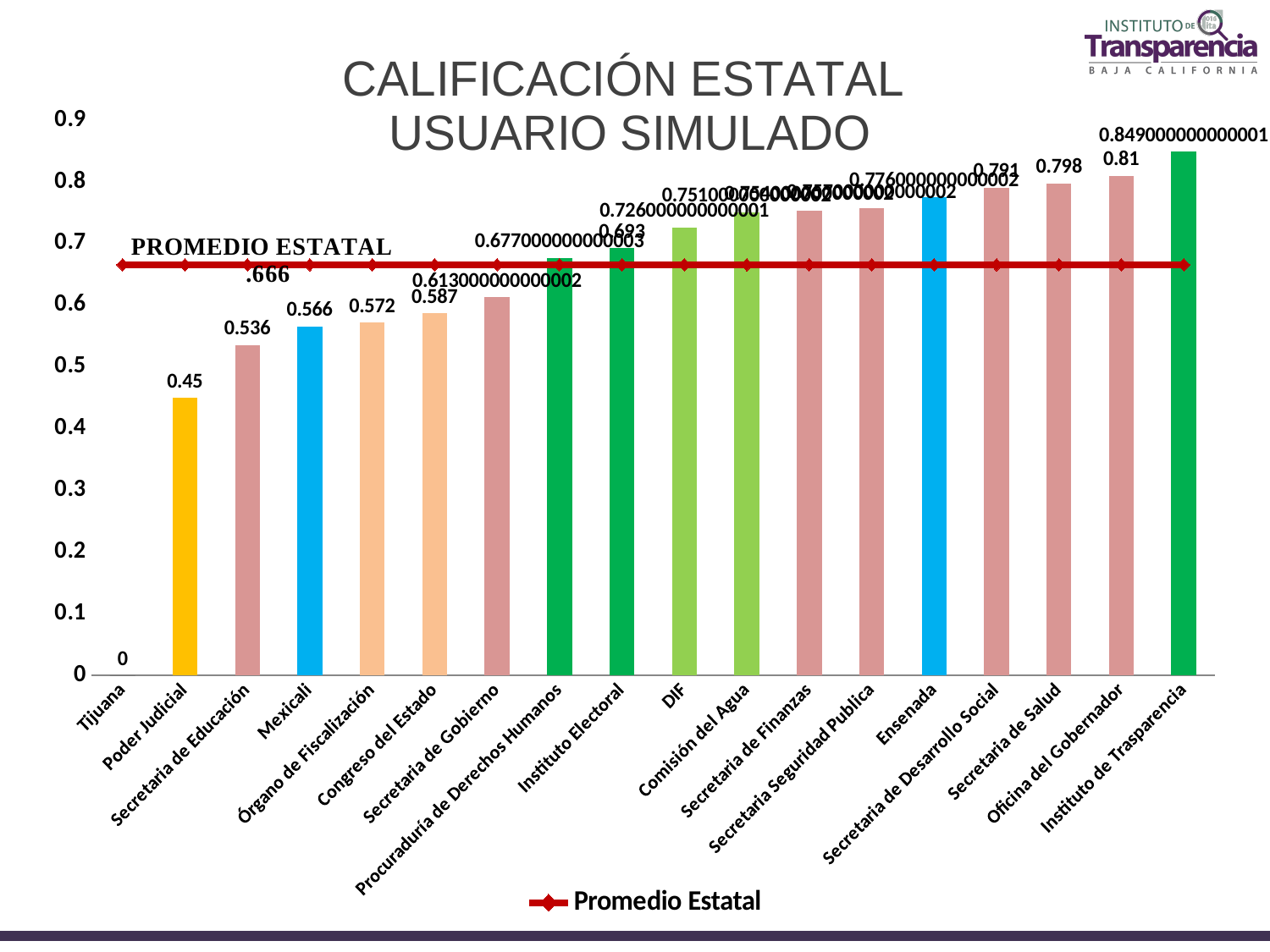
How many series does the legend list? 1 Which category has the highest value? Instituto de Trasparencia Which is larger, the value for Secretaria de Educación or the value for Congreso del Estado? Congreso del Estado What is the value for Instituto Electoral? 0.693 Which category has the lowest value? Tijuana What value is shown for the Promedio Estatal line? .666 What is the value for Secretaria de Salud? 0.798 Is the value for Ensenada greater or less than 0.7? greater What is the value for Poder Judicial? 0.45 What is the difference between the values for Oficina del Gobernador and Secretaria de Salud? 0.012 What kind of chart is this? combination bar and line chart How many categories are shown on the x axis? 18